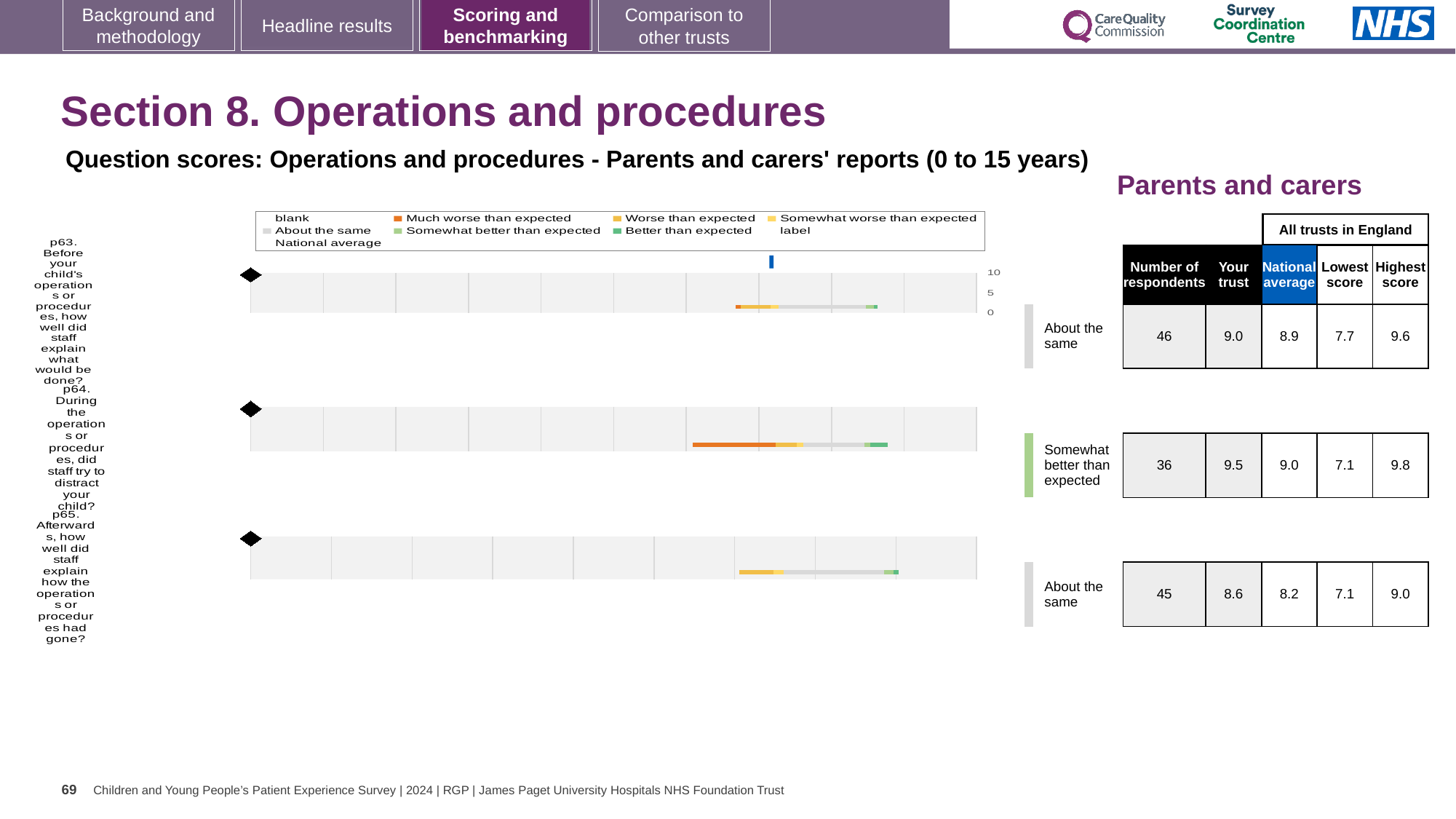
What is the number of respondents for p63 (Before your child's operations or procedures, how well did staff explain what would be done?)? 46 What kind of chart is used for the question scores on this slide? bar chart What benchmark category is shown for p64? Somewhat better than expected For p65, is the 'Your trust' score higher or lower than the national average? higher Which question has the highest 'Your trust' score? p64 For p64, what is the difference between the 'Your trust' score and the national average? 0.5 Which respondent group do these question scores cover, according to the heading above the table? Parents and carers How many questions (p63, p64, p65) are charted on this slide? 3 Which question has the lowest national average score? p65 What is the national average score for p65 (Afterwards, how well did staff explain how the operations or procedures had gone?)? 8.2 What is the highest score across all trusts in England for p63? 9.6 What is the 'Your trust' score for p64 (During the operations or procedures, did staff try to distract your child?)? 9.5